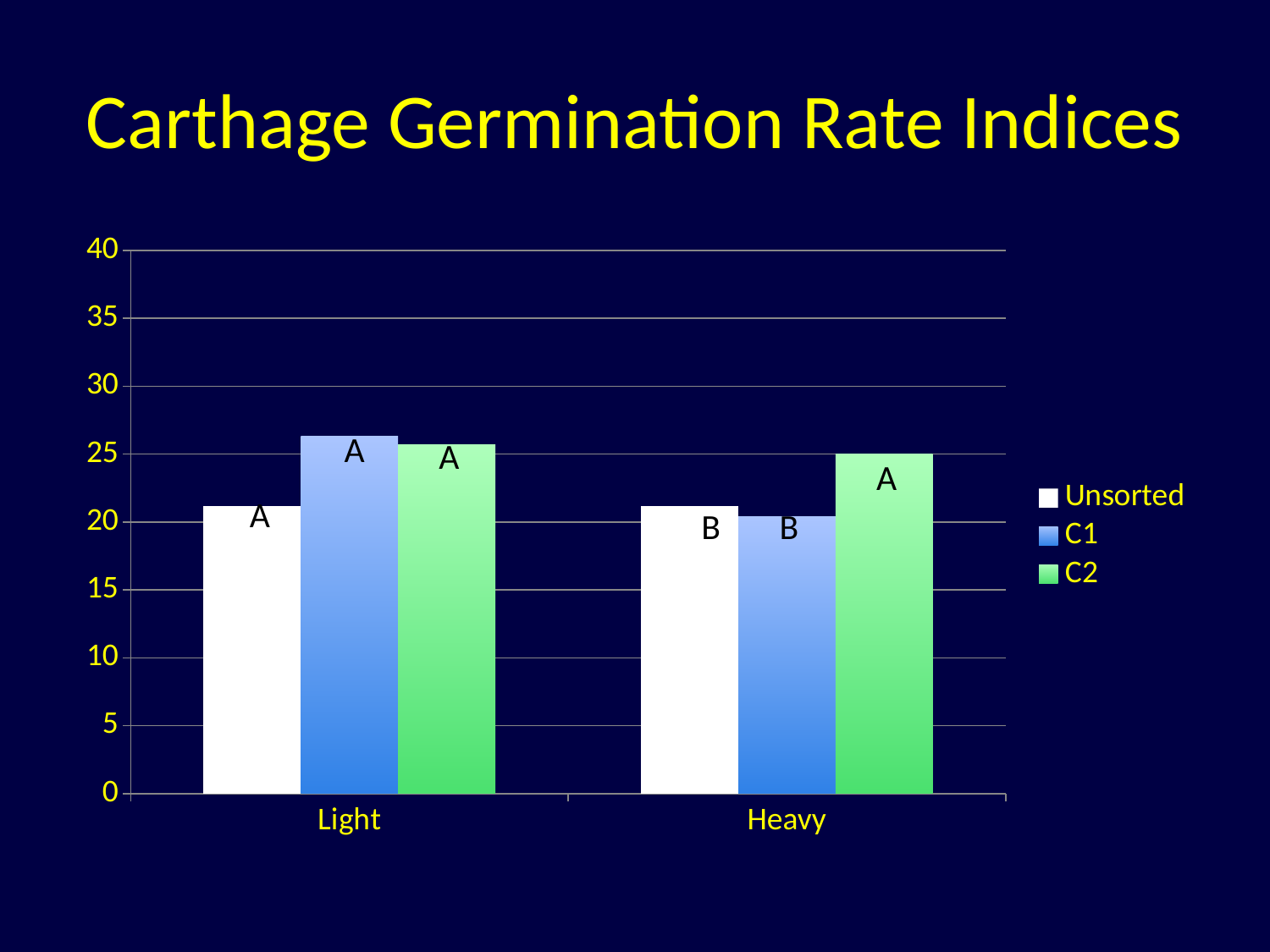
Is the value for Unsorted in the Heavy category greater or less than 25? less Which series has the highest value in the Heavy category? C2 Is the value for C2 in the Heavy category greater or less than 30? less What kind of chart is shown on the slide? bar chart Which is larger, the C1 value for Light or the C1 value for Heavy? Light Which series are listed in the legend? Unsorted, C1, C2 Is the value for C1 in the Light category greater or less than 25? greater What is the title of the chart? Carthage Germination Rate Indices Which is larger in the Heavy category, the C2 value or the Unsorted value? C2 How many series does the legend list? 3 How many categories are shown on the x axis? 2